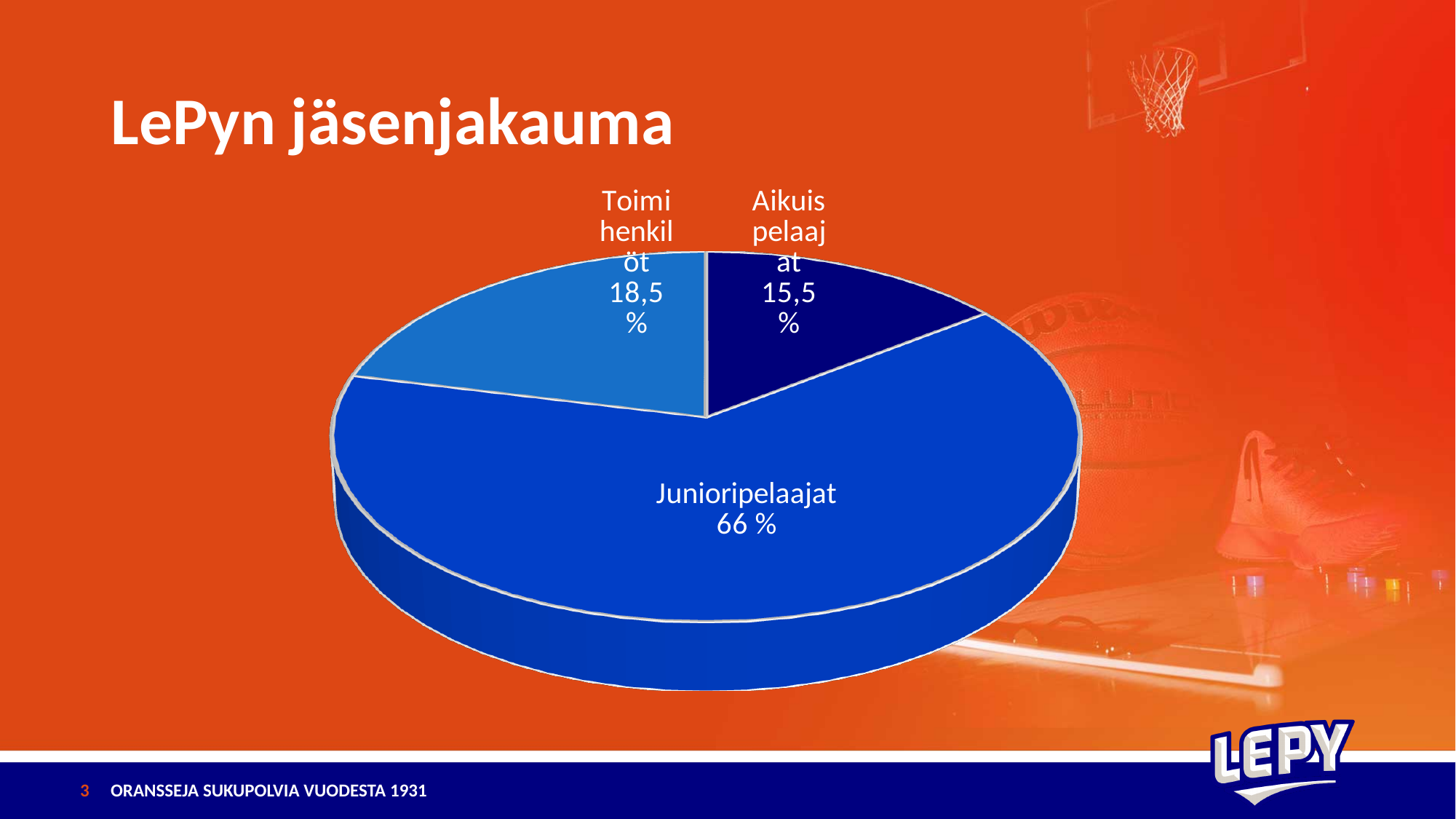
What kind of chart is shown on the slide? Pie chart What share of the pie does Toimihenkilöt have? 18,5 % How many slices does the pie chart have? 3 Which category has the largest slice of the pie? Junioripelaajat What colour is the Junioripelaajat slice? Blue What is the difference between the shares of Toimihenkilöt and Aikuispelaajat? 3 % Which category has the smallest slice of the pie? Aikuispelaajat What is the title of the slide containing the chart? LePyn jäsenjakauma What share of the pie does Aikuispelaajat have? 15,5 % Which is larger, the share of Toimihenkilöt or the share of Aikuispelaajat? Toimihenkilöt What share of the pie does Junioripelaajat have? 66 % What is the difference between the shares of Junioripelaajat and Toimihenkilöt? 47,5 %